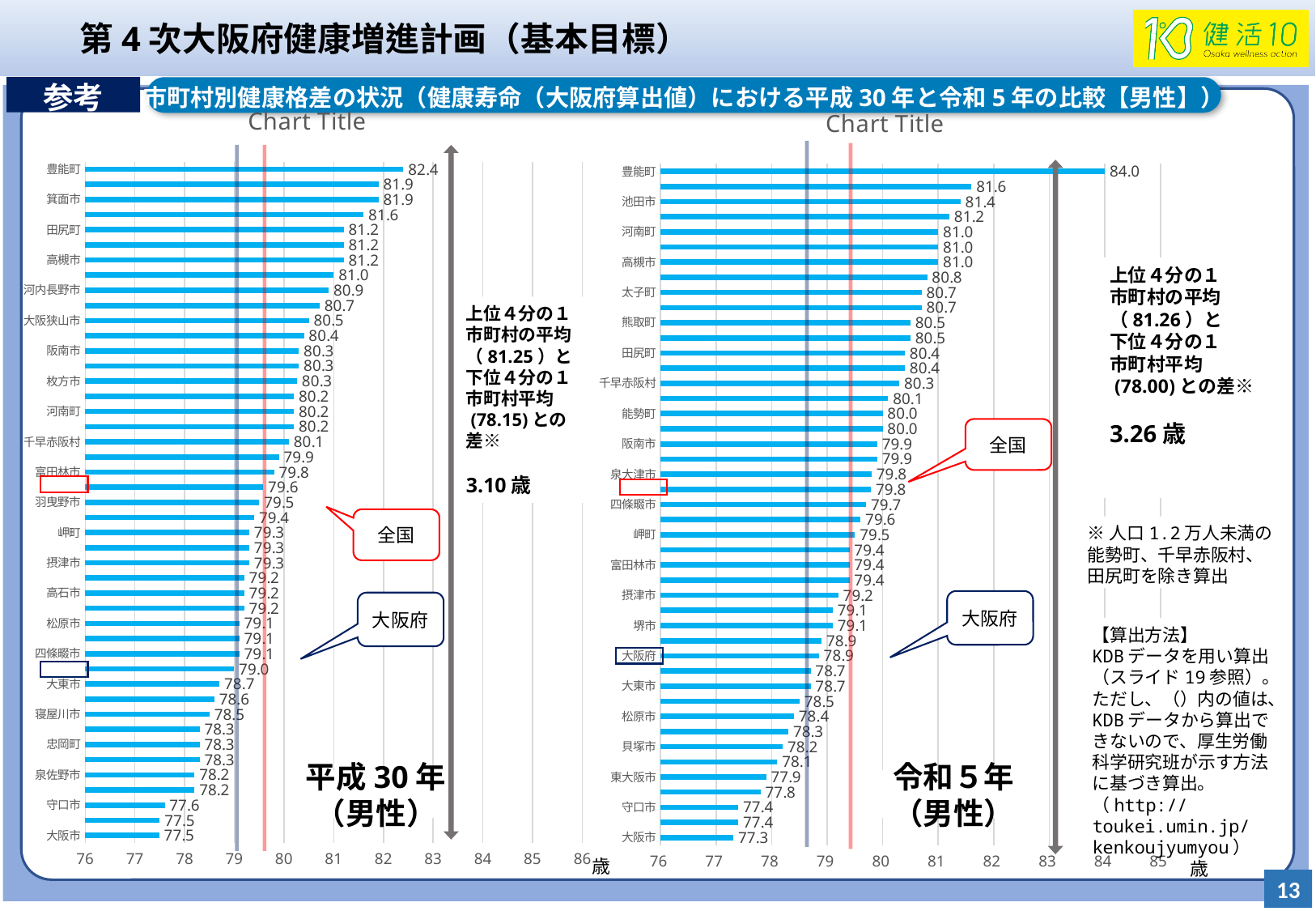
What kind of chart is the left chart (平成30年（男性）)? bar chart On the right chart (令和5年（男性）), which municipality has the highest value? 豊能町 On the left chart (平成30年（男性）), what is the difference between 箕面市 and 守口市? 4.3 On the left chart (平成30年（男性）), what is the value for 豊能町? 82.4 On the right chart (令和5年（男性）), what is the difference between 豊能町 and 大阪市? 6.7 On the right chart (令和5年（男性）), is the value for 池田市 greater or less than 80? greater On the right chart (令和5年（男性）), what is the value for 大阪府? 78.9 On the left chart (平成30年（男性）), which municipality has the lowest value? 大阪市 On the right chart (令和5年（男性）), what is the value for 豊能町? 84.0 On the left chart (平成30年（男性）), which is larger, the value for 高槻市 or the value for 大東市? 高槻市 On the right chart (令和5年（男性）), what is the value for 守口市? 77.4 On the left chart (平成30年（男性）), what is the value for 大阪市? 77.5